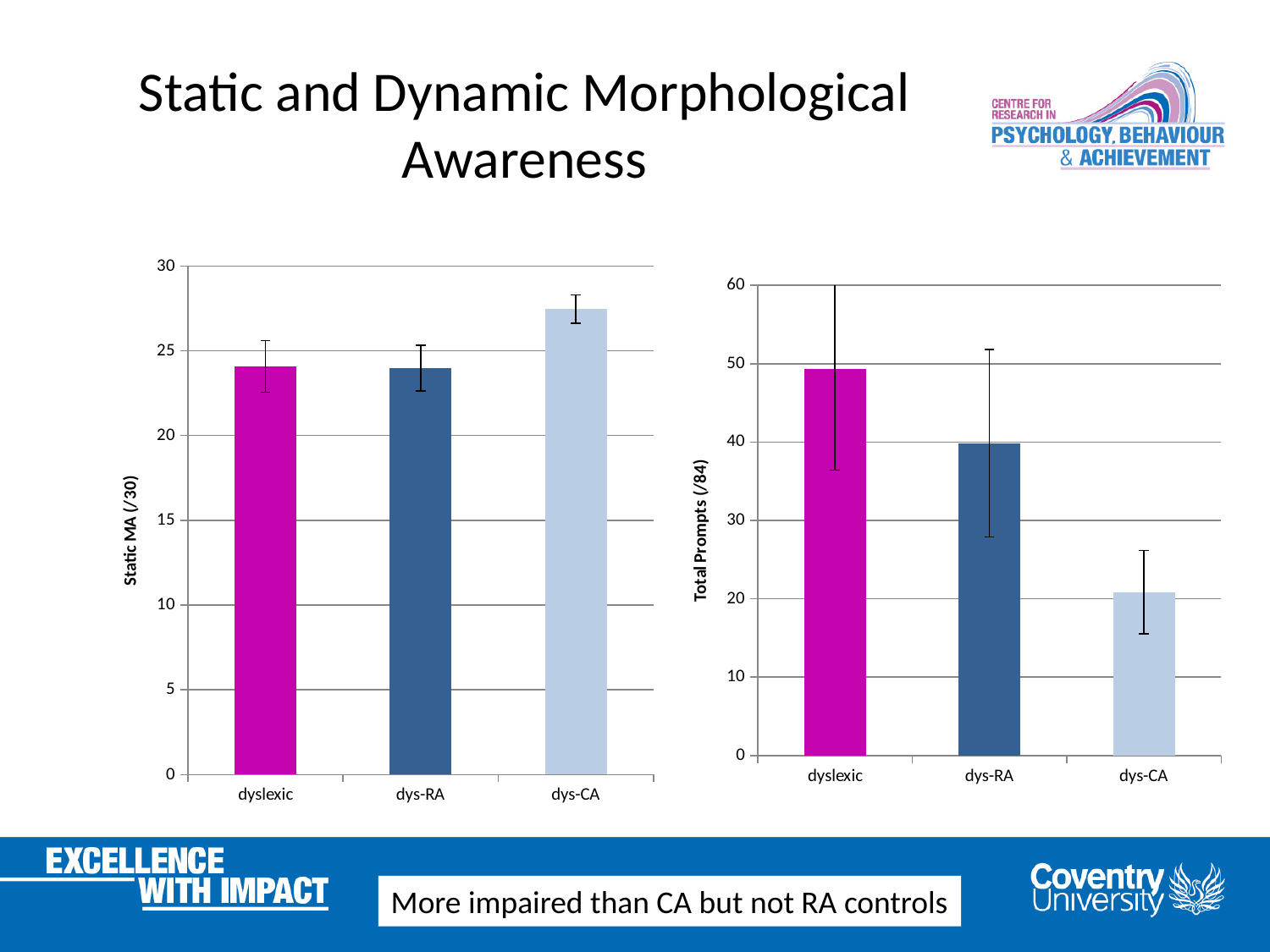
In the left chart (Static MA), is the value for dyslexic greater or less than 25? less In the right chart (Total Prompts), do the bar values rise or fall from dyslexic to dys-CA along the x axis? fall In the right chart (Total Prompts), is the value for dyslexic greater or less than 40? greater What is the y-axis label of the left chart? Static MA (/30) How many categories are shown on the x axis of the right chart (Total Prompts)? 3 In the left chart (Static MA), which category has the highest bar? dys-CA In the left chart (Static MA), is the value for dys-CA greater or less than 25? greater In the right chart (Total Prompts), which category has the highest bar? dyslexic In the right chart (Total Prompts), which is larger, the value for dyslexic or the value for dys-CA? dyslexic What kind of chart is the left chart on the slide? bar chart In the right chart (Total Prompts), which category has the lowest bar? dys-CA